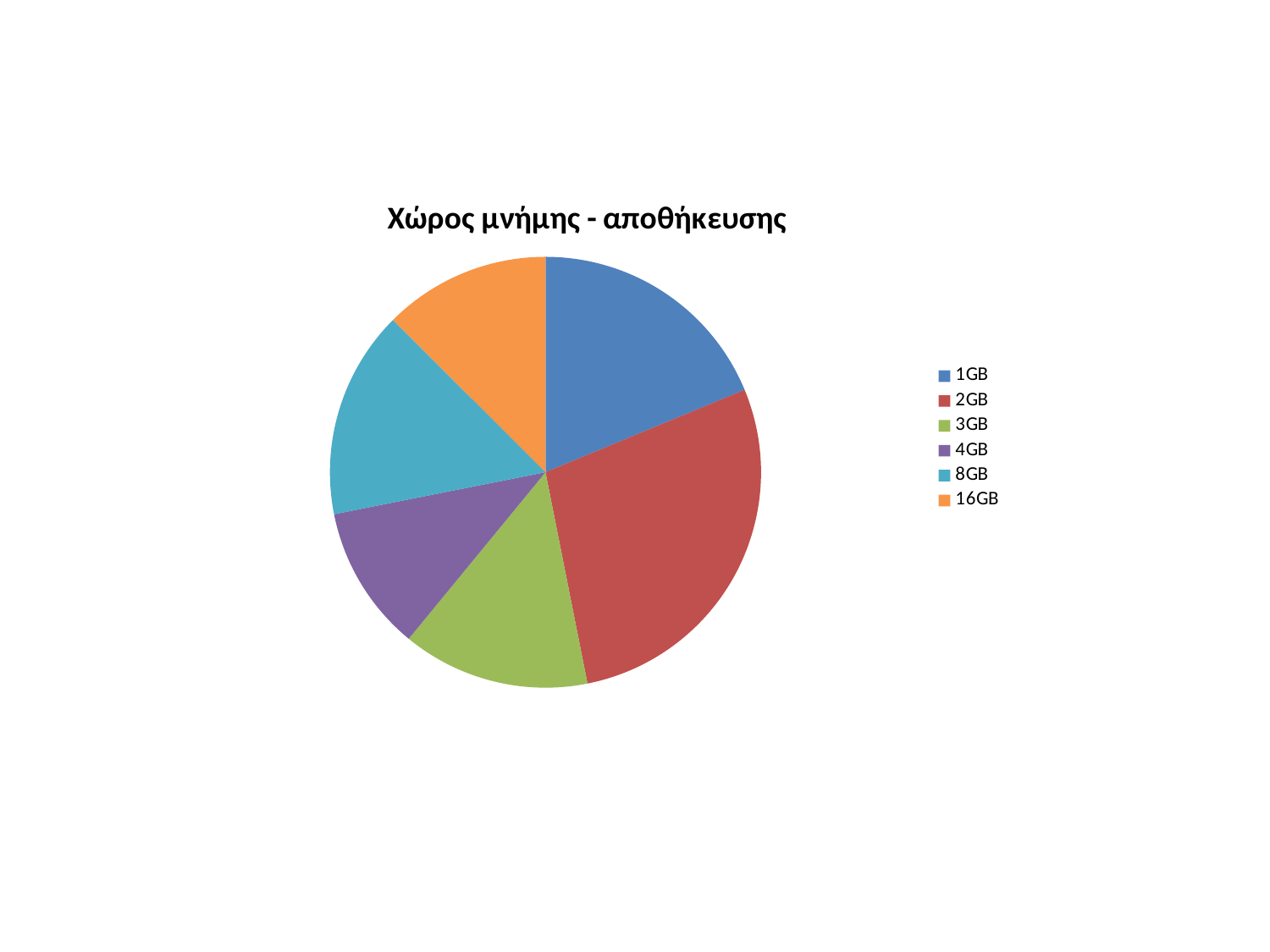
How many slices does the pie chart have? 6 What kind of chart is shown on the slide? pie chart What is the title of the chart? Χώρος μνήμης - αποθήκευσης Which category has the largest slice of the pie? 2GB Which slice is larger, 1GB or 4GB? 1GB How many entries does the legend list? 6 Which slice is larger, 2GB or 1GB? 2GB What colour is the 2GB slice? red Which slice is larger, 2GB or 8GB? 2GB